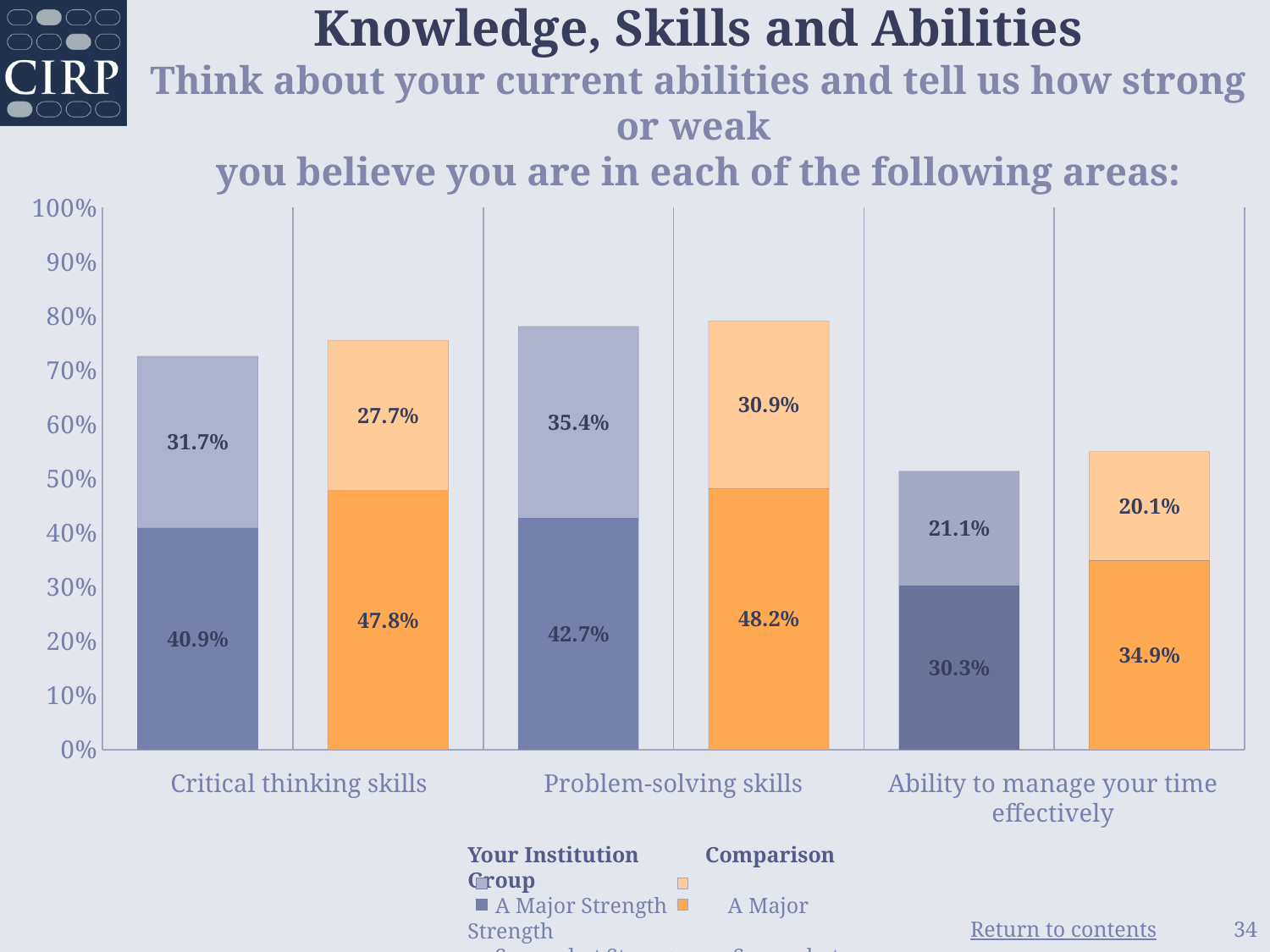
What percentage of the Comparison Group rated problem-solving skills as a major strength? 48.2% What is the total height of the Comparison Group stacked bar for ability to manage your time effectively? 55.0% How many areas (categories) are shown on the x axis of the chart? 3 What is the value of the upper (lighter) segment of the Your Institution bar for ability to manage your time effectively? 21.1% What is the difference between the Comparison Group and Your Institution 'A Major Strength' percentages for critical thinking skills? 6.9% What is the value of the upper (lighter) segment of the Comparison Group bar for critical thinking skills? 27.7% What percentage of Your Institution respondents rated critical thinking skills as a major strength? 40.9% What is the total height of the Your Institution stacked bar for problem-solving skills? 78.1% What type of chart is shown on the slide? Stacked bar chart For problem-solving skills, which group has the larger 'A Major Strength' percentage, Your Institution or the Comparison Group? Comparison Group Which area has the lowest 'A Major Strength' percentage for Your Institution? Ability to manage your time effectively Which area has the highest 'A Major Strength' percentage for the Comparison Group? Problem-solving skills